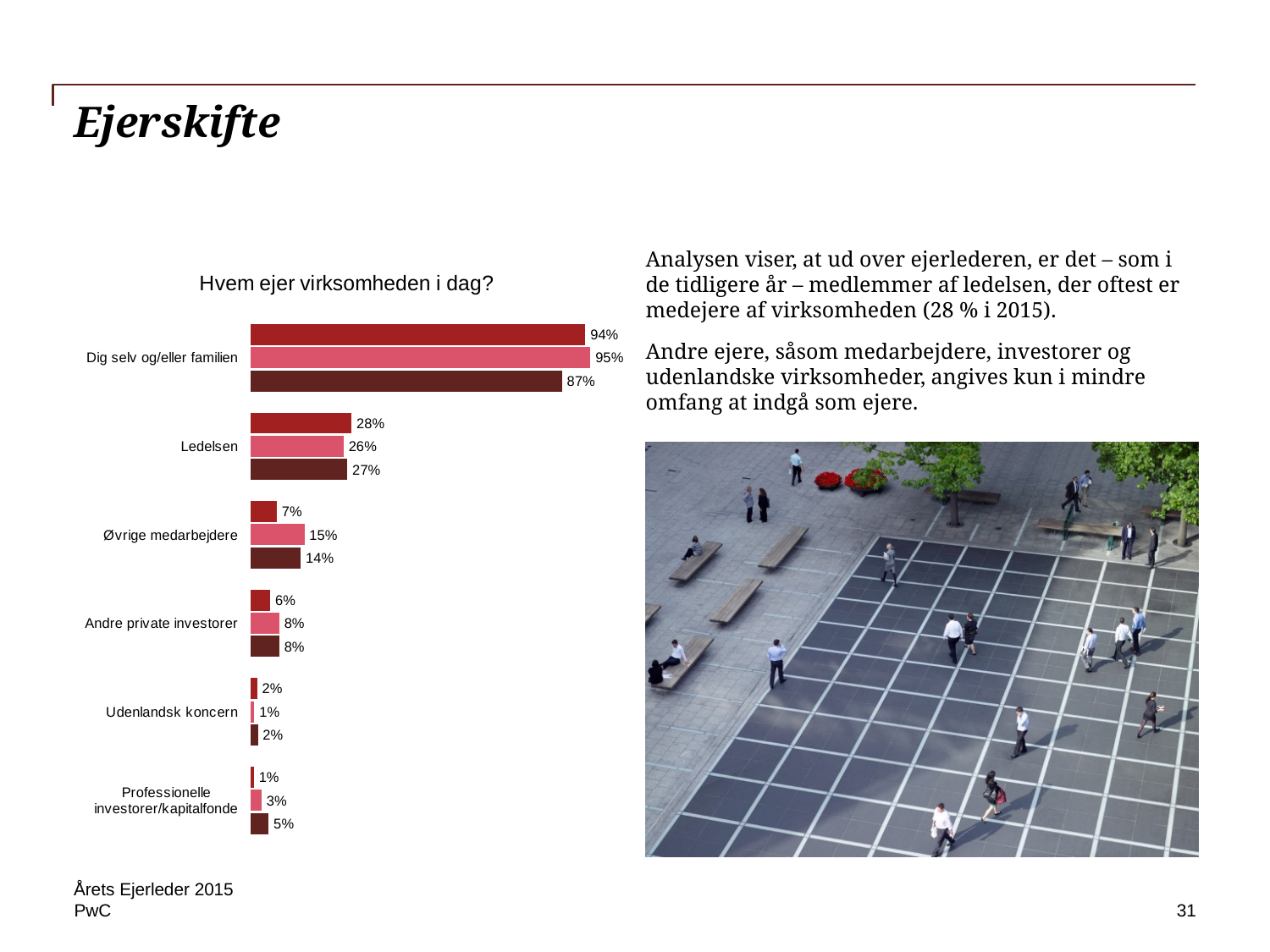
What is the value of the top (red) bar for Ledelsen? 28% What kind of chart is shown on the slide? bar chart What is the difference between the top (red) bar and the bottom (dark red) bar for Dig selv og/eller familien? 7% How many categories does the chart show? 6 What is the value of the middle (pink) bar for Udenlandsk koncern? 1% What is the value of the bottom (dark red) bar for Dig selv og/eller familien? 87% What is the title of the chart? Hvem ejer virksomheden i dag? Which is larger for Andre private investorer: the top (red) bar or the middle (pink) bar? the middle (pink) bar What is the difference between the middle (pink) bar and the top (red) bar for Øvrige medarbejdere? 8% What is the value of the bottom (dark red) bar for Professionelle investorer/kapitalfonde? 5% Which category has the highest values in the chart? Dig selv og/eller familien What is the value of the middle (pink) bar for Øvrige medarbejdere? 15%